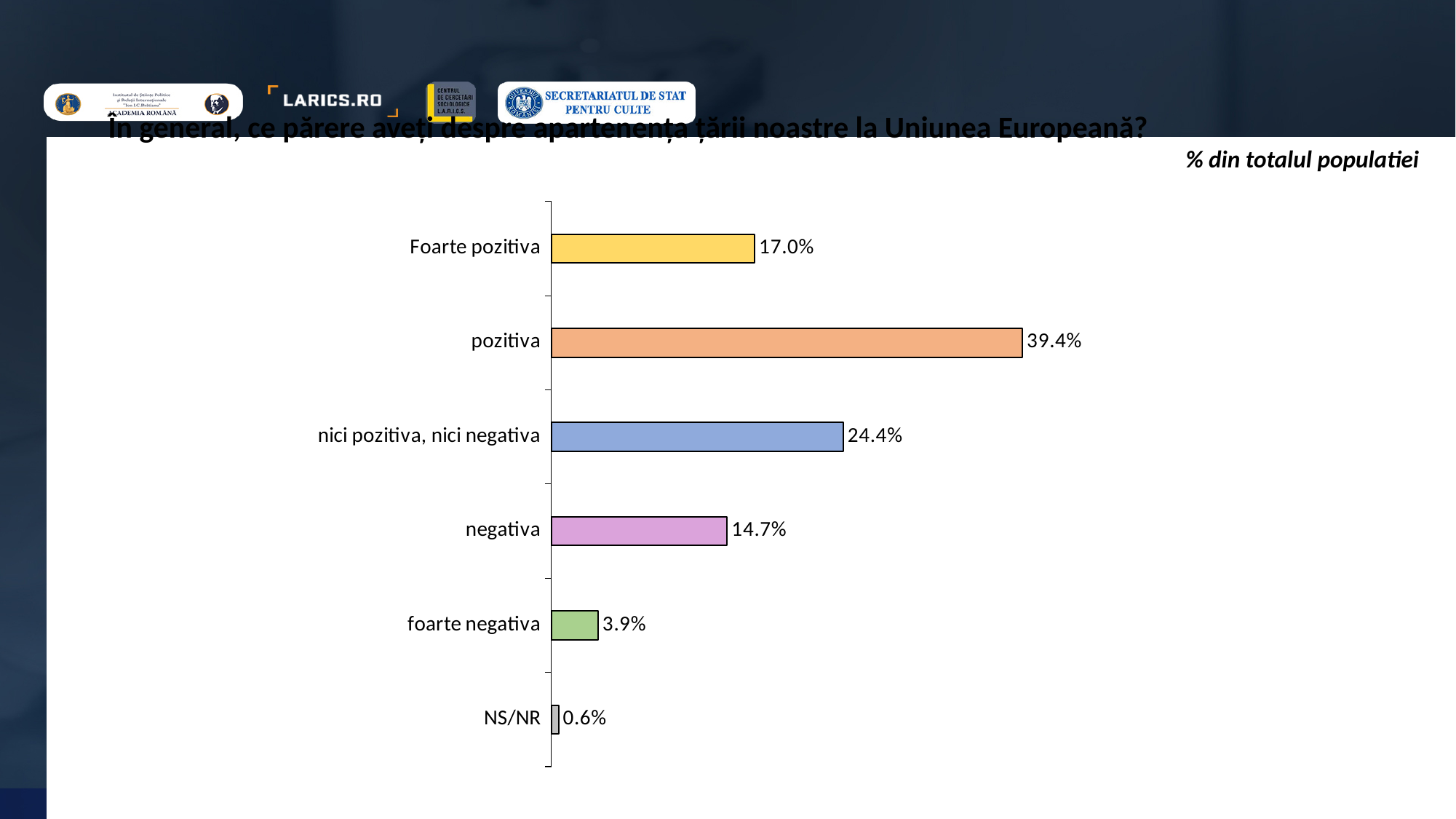
What unit note is shown at the top right of the chart? % din totalul populatiei How many categories are shown in the chart? 6 What kind of chart is shown on the slide? bar chart Which category has the lowest value? NS/NR What is the value for "nici pozitiva, nici negativa"? 24.4% What is the value for "pozitiva"? 39.4% What is the value for "NS/NR"? 0.6% What is the value for "foarte negativa"? 3.9% Which category has the highest value? pozitiva What is the value for "Foarte pozitiva"? 17.0% What is the difference between the values for "pozitiva" and "negativa"? 24.7% Which is larger, the value for "Foarte pozitiva" or the value for "negativa"? Foarte pozitiva